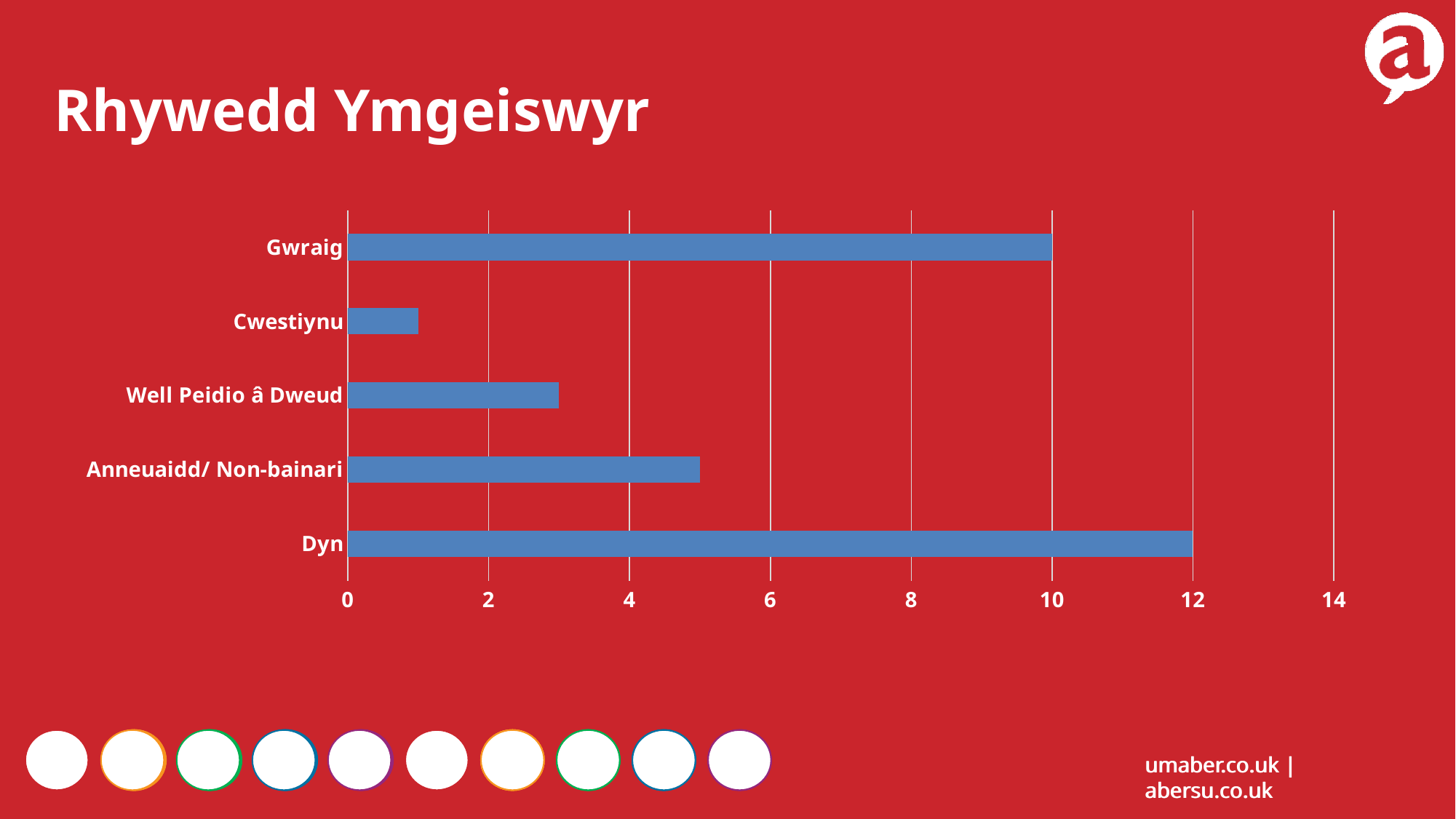
Which is larger, the value for Anneuaidd/ Non-bainari or the value for Well Peidio â Dweud? Anneuaidd/ Non-bainari Which category has the highest value? Dyn What is the value for Dyn? 12 Is the value for Well Peidio â Dweud greater or less than 4? less Is the value for Cwestiynu greater or less than 2? less What is the difference between the values for Dyn and Gwraig? 2 How many categories are shown in the chart? 5 Which category has the lowest value? Cwestiynu What is the title of the chart? Rhywedd Ymgeiswyr What is the value for Gwraig? 10 Is the value for Anneuaidd/ Non-bainari greater or less than 4? greater What type of chart is shown on the slide? bar chart